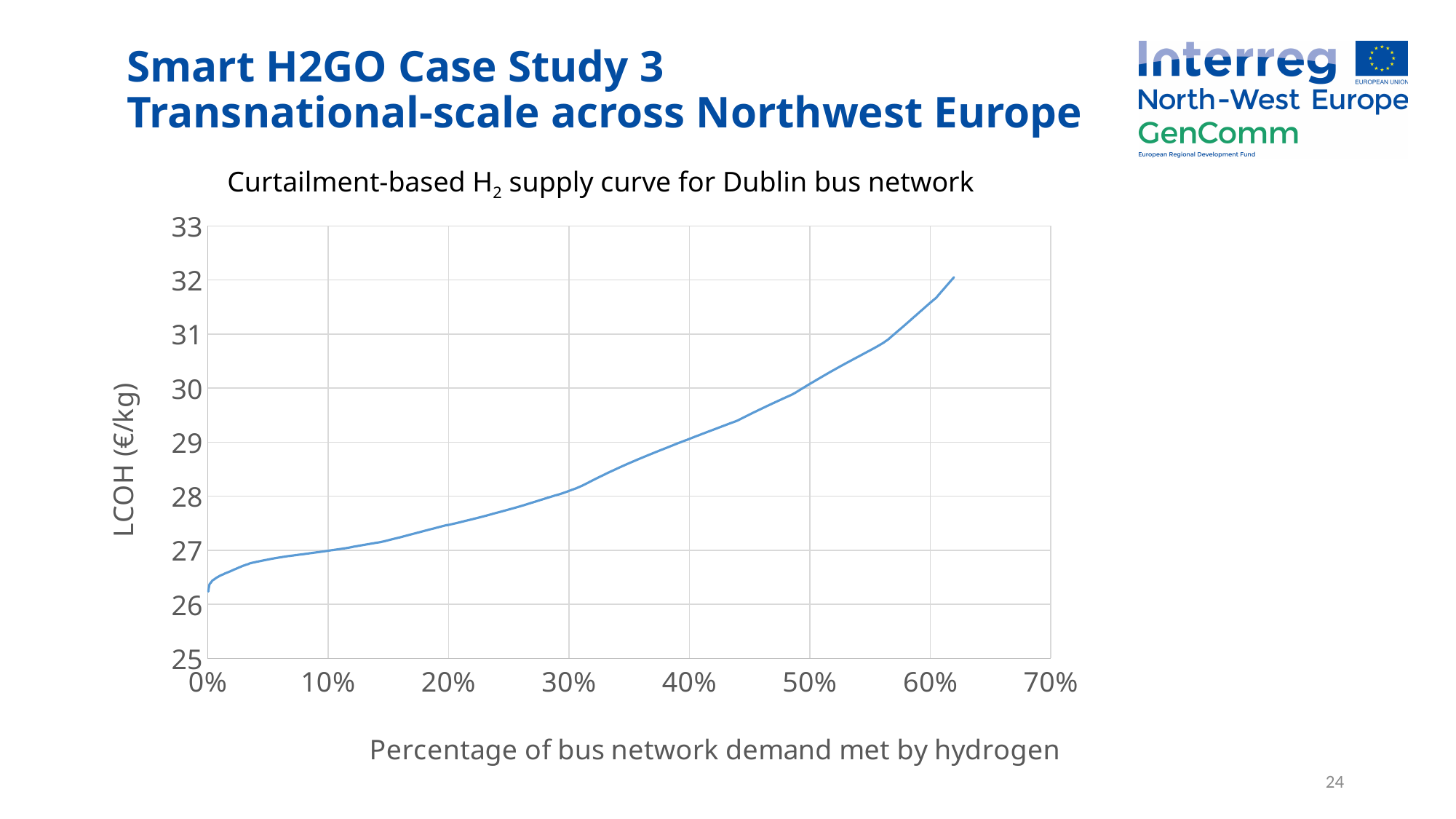
Is the LCOH at 0% of bus network demand met by hydrogen greater or less than 27 €/kg? less Is the LCOH at 20% of bus network demand met by hydrogen greater or less than 28 €/kg? less Is the LCOH at 60% of bus network demand met by hydrogen greater or less than 31 €/kg? greater Which is larger, the LCOH at 10% or the LCOH at 50% of bus network demand met by hydrogen? 50% What is the title of the chart? Curtailment-based H2 supply curve for Dublin bus network Does the LCOH rise or fall as the percentage of bus network demand met by hydrogen increases? rise At which end of the curve is the LCOH lowest, 0% or the right-hand end near 60%? 0% What is the label of the vertical axis? LCOH (€/kg) What kind of chart is shown on the slide? line chart